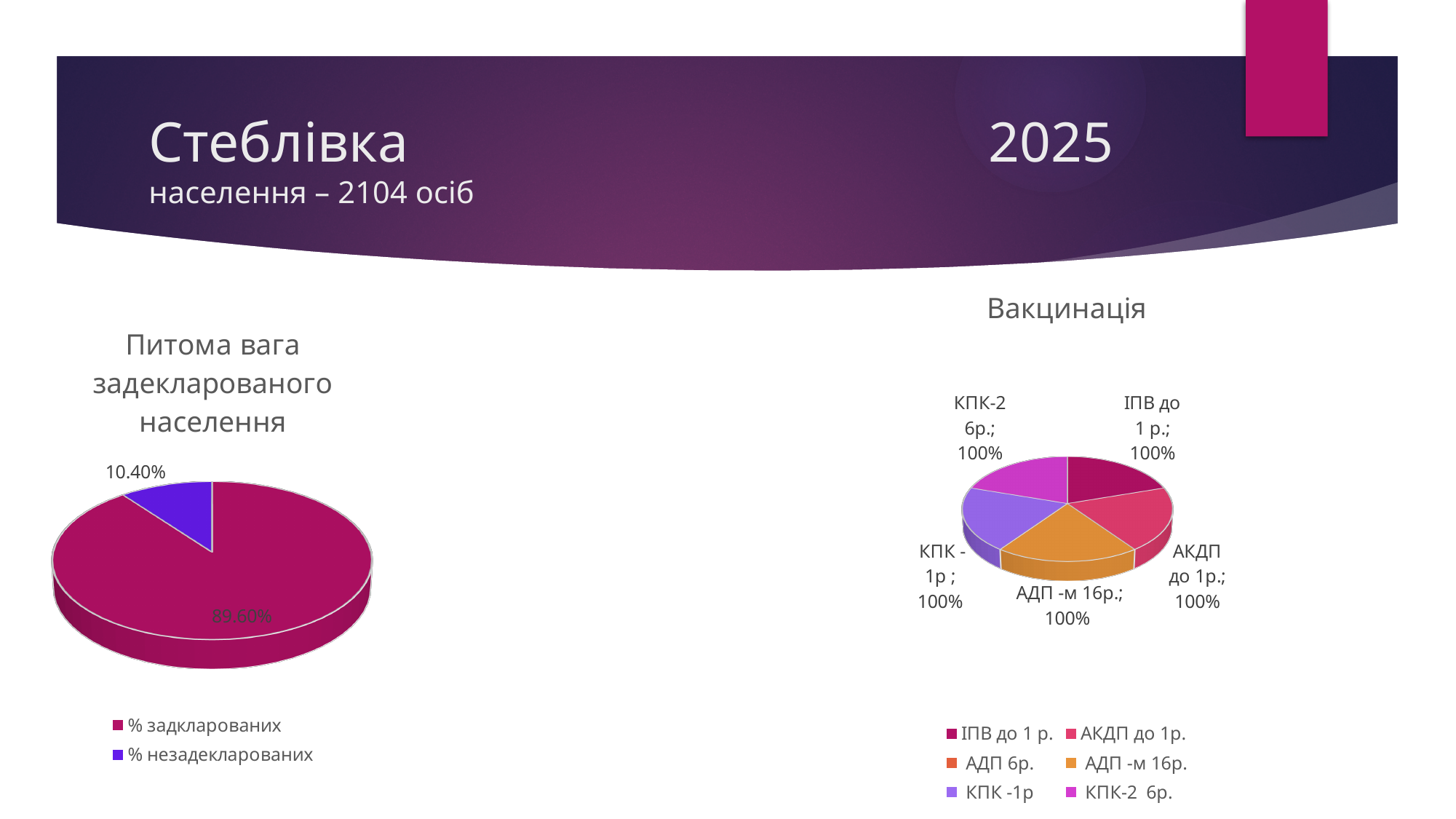
On the chart titled "Питома вага задекларованого населення", what is the difference between the two slice values? 79.20% On the chart titled "Вакцинація", how many slices are labelled with a value on the pie? 5 On the chart titled "Вакцинація", what value is shown for "ІПВ до 1 р."? 100% On the chart titled "Вакцинація", what value is shown for "АДП -м 16р."? 100% On the chart titled "Питома вага задекларованого населення", how many entries does the legend list? 2 On the chart titled "Питома вага задекларованого населення", which category has the largest slice? % задкларованих On the chart titled "Питома вага задекларованого населення", what is the value for "% задклярованих"? 89.60% On the chart titled "Питома вага задекларованого населення", what is the value for "% незадекларованих"? 10.40% What kind of chart is the chart titled "Вакцинація"? Pie chart On the chart titled "Питома вага задекларованого населення", which category has the smallest slice? % незадекларованих What kind of chart is the chart titled "Питома вага задекларованого населення"? Pie chart On the chart titled "Вакцинація", how many entries does the legend list? 6